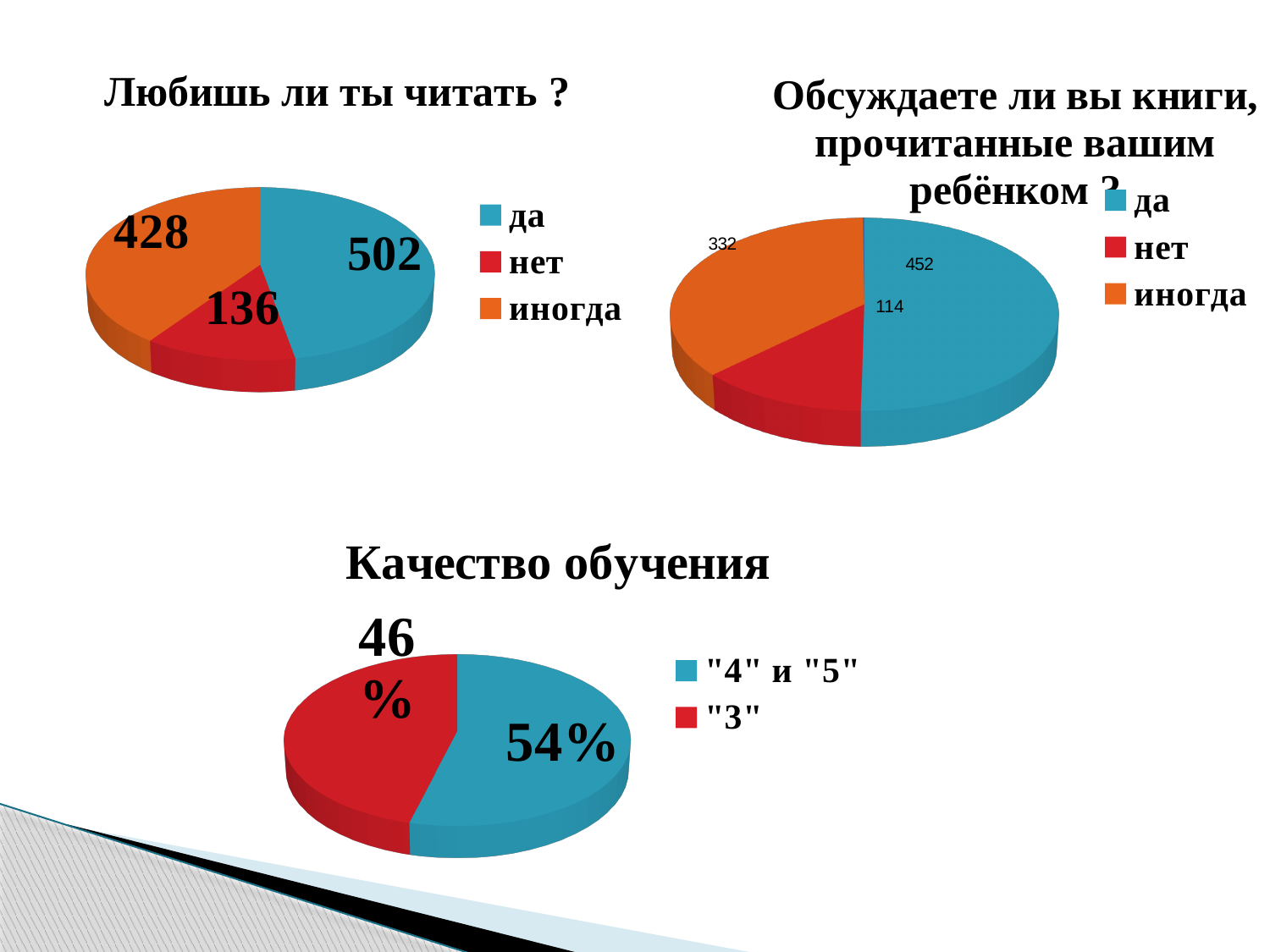
In the chart titled "Обсуждаете ли вы книги, прочитанные вашим ребёнком ?", how many categories does the legend list? 3 In the chart titled "Качество обучения", which is larger, "4" и "5" or "3"? "4" и "5" In the chart titled "Любишь ли ты читать ?", what colour is the "иногда" slice? orange In the chart titled "Любишь ли ты читать ?", what is the value for "нет"? 136 In the chart titled "Обсуждаете ли вы книги, прочитанные вашим ребёнком ?", what is the value for "иногда"? 332 What kind of chart is the chart titled "Качество обучения"? pie chart In the chart titled "Обсуждаете ли вы книги, прочитанные вашим ребёнком ?", which category has the largest value? да In the chart titled "Любишь ли ты читать ?", what is the value for "да"? 502 In the chart titled "Любишь ли ты читать ?", which category has the smallest value? нет In the chart titled "Любишь ли ты читать ?", what is the difference between the values for "да" and "иногда"? 74 In the chart titled "Обсуждаете ли вы книги, прочитанные вашим ребёнком ?", what is the difference between the values for "да" and "нет"? 338 In the chart titled "Качество обучения", what is the value for "3"? 46%